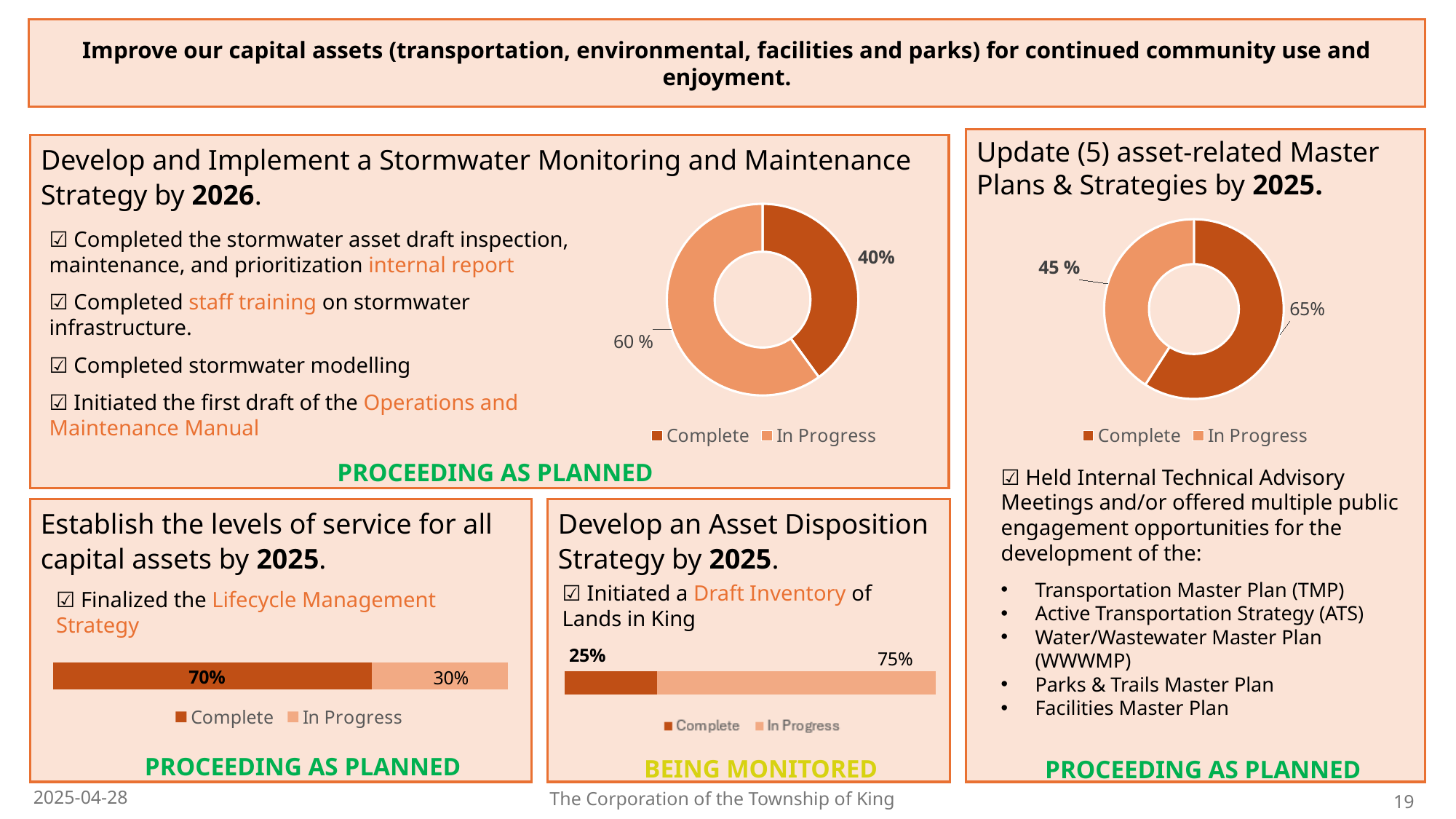
In the Develop an Asset Disposition Strategy chart, which segment is larger, Complete or In Progress? In Progress In the Develop an Asset Disposition Strategy chart, what percentage is In Progress? 75% How many series does the legend list in the Develop an Asset Disposition Strategy chart? 2 In the Stormwater Monitoring and Maintenance Strategy chart, what percentage is shown for Complete? 40% In the Establish the levels of service chart, what percentage is Complete? 70% In the Update (5) asset-related Master Plans & Strategies chart, which slice is larger, Complete or In Progress? Complete What kind of chart is used in the Stormwater Monitoring and Maintenance Strategy panel? Donut chart In the Update (5) asset-related Master Plans & Strategies chart, what percentage is labelled for Complete? 65% In the Establish the levels of service chart, what is the difference between the Complete and In Progress percentages? 40% In the Stormwater Monitoring and Maintenance Strategy chart, what percentage is shown for In Progress? 60 % In the Update (5) asset-related Master Plans & Strategies chart, what percentage is labelled for In Progress? 45 % What kind of chart is used in the Establish the levels of service panel? Bar chart